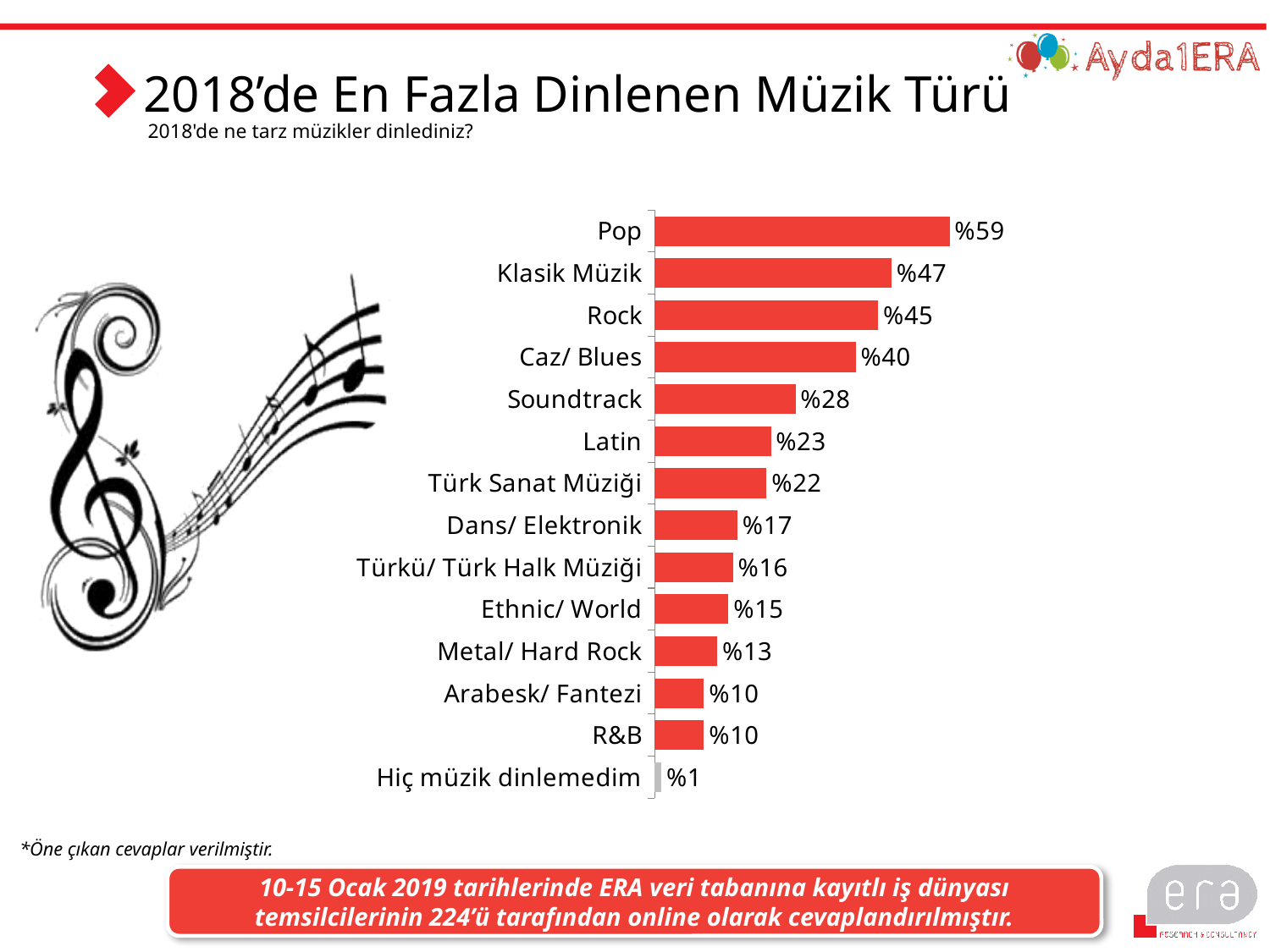
Which category has the lowest value? Hiç müzik dinlemedim What kind of chart is shown on the slide? Bar chart What is the value for Türkü/ Türk Halk Müziği? %16 What is the value for Pop? %59 What is the title of the chart on the slide? 2018'de En Fazla Dinlenen Müzik Türü Which is larger, the value for Dans/ Elektronik or the value for Metal/ Hard Rock? Dans/ Elektronik Which category has the highest value? Pop Which is larger, the value for Rock or the value for Caz/ Blues? Rock How many categories are shown in the chart? 14 What is the difference between the values for Caz/ Blues and Latin? %17 What is the difference between the values for Pop and Klasik Müzik? %12 What is the value for Soundtrack? %28